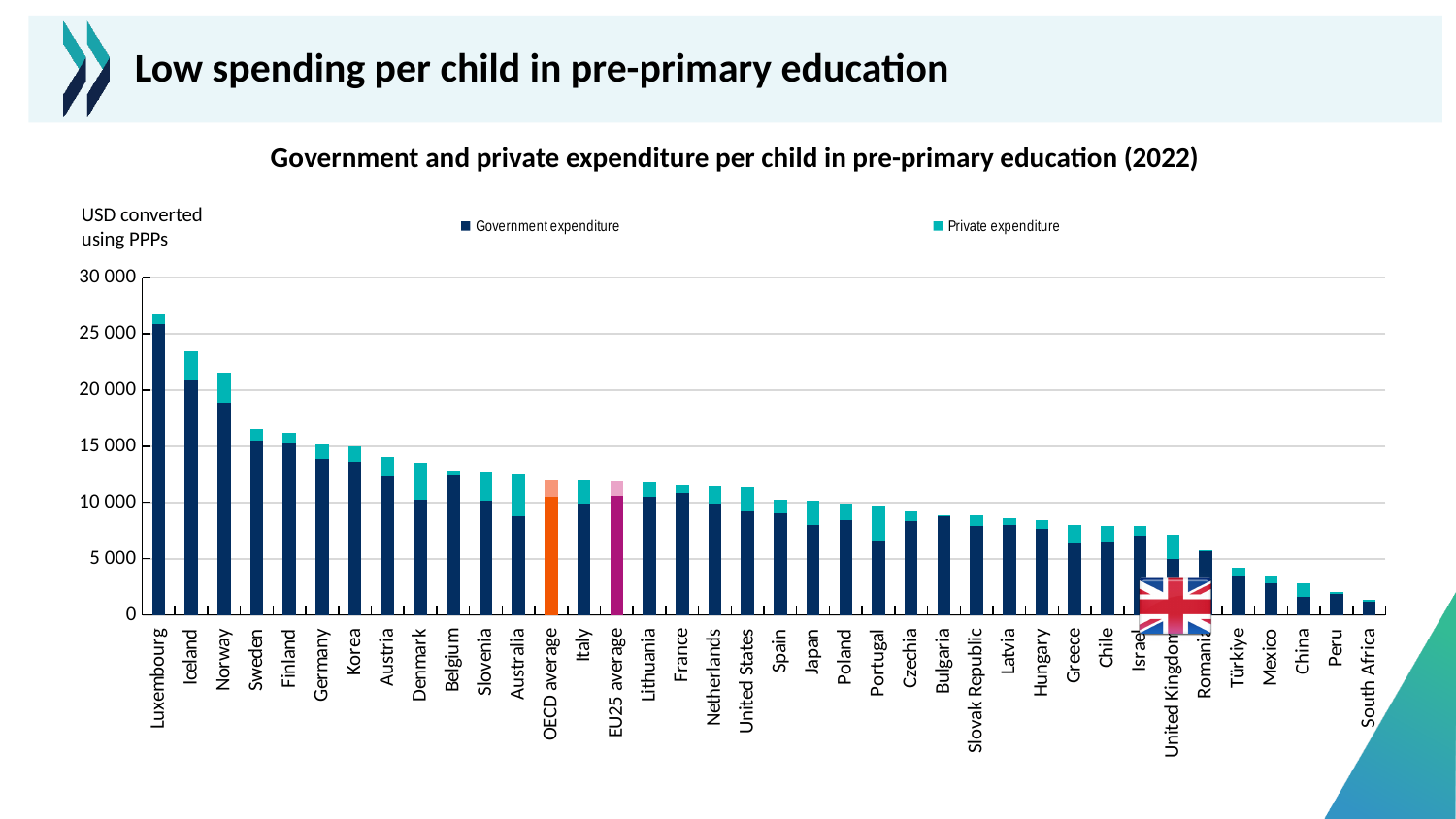
What are the two series named in the legend? Government expenditure and Private expenditure Is the total expenditure per child for Luxembourg greater or less than 25 000? greater Is the total expenditure per child for Norway greater or less than 20 000? greater Do the total expenditure values rise or fall moving from left to right along the x axis? Fall Which has the larger total expenditure per child, Iceland or Norway? Iceland How many series does the legend list? 2 What kind of chart is shown on the slide? Stacked bar chart Which country has the lowest total expenditure per child in pre-primary education? South Africa Which country has the highest total expenditure per child in pre-primary education? Luxembourg Is the total expenditure per child for Türkiye greater or less than 5 000? less